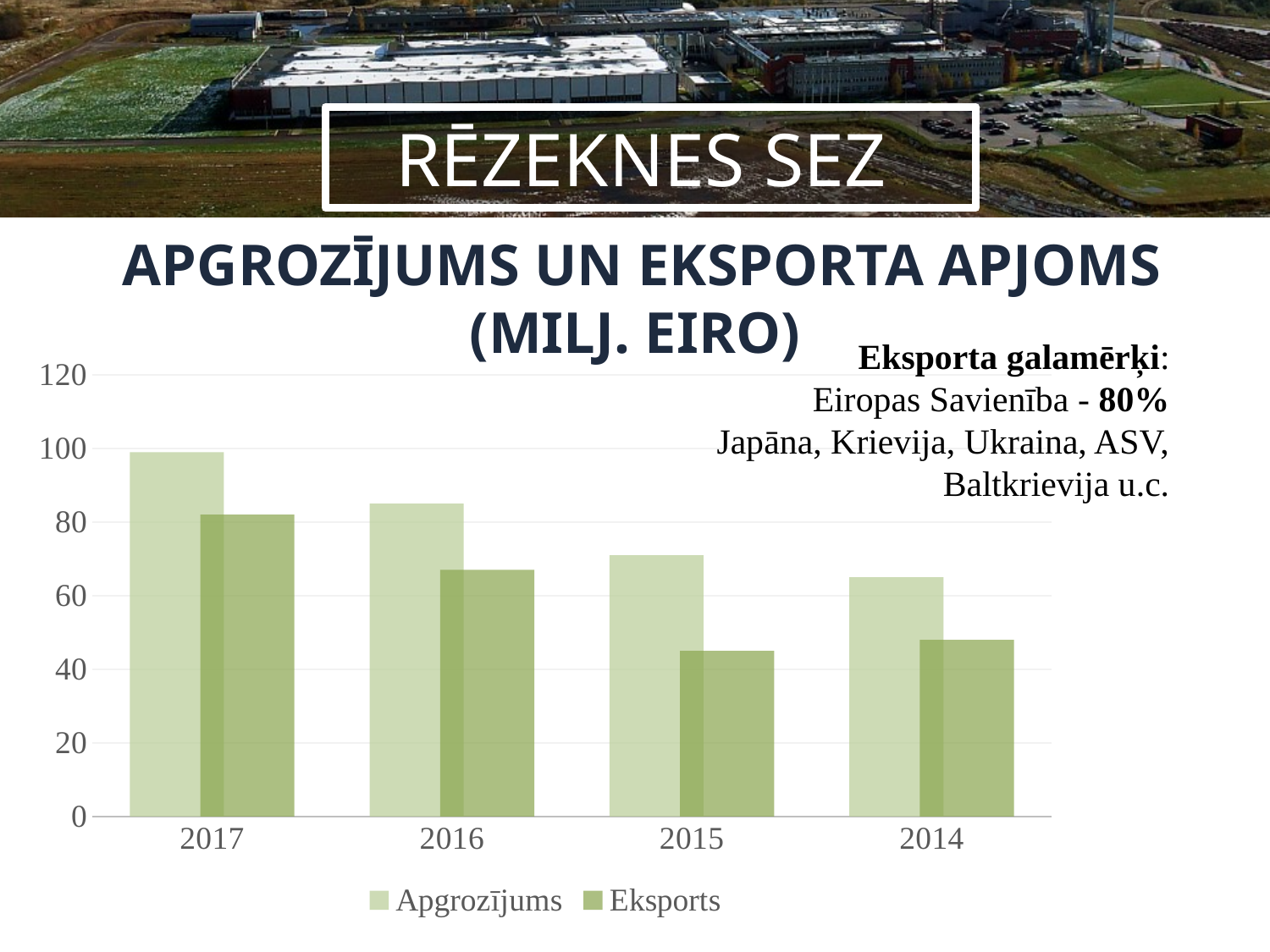
Is the Eksports value for 2015 greater or less than 60? less Which year has the lowest Apgrozījums value? 2014 Which year has the highest Eksports value? 2017 Which is larger, the Apgrozījums value for 2016 or for 2015? 2016 What kind of chart is shown on the slide? bar chart Is the Apgrozījums value for 2014 greater or less than 80? less How many years are shown on the x axis of the chart? 4 Which year has the highest Apgrozījums value? 2017 Is the Apgrozījums value for 2016 greater or less than 100? less How many series does the chart legend list? 2 Do the Apgrozījums values rise or fall moving from left to right along the x axis? fall